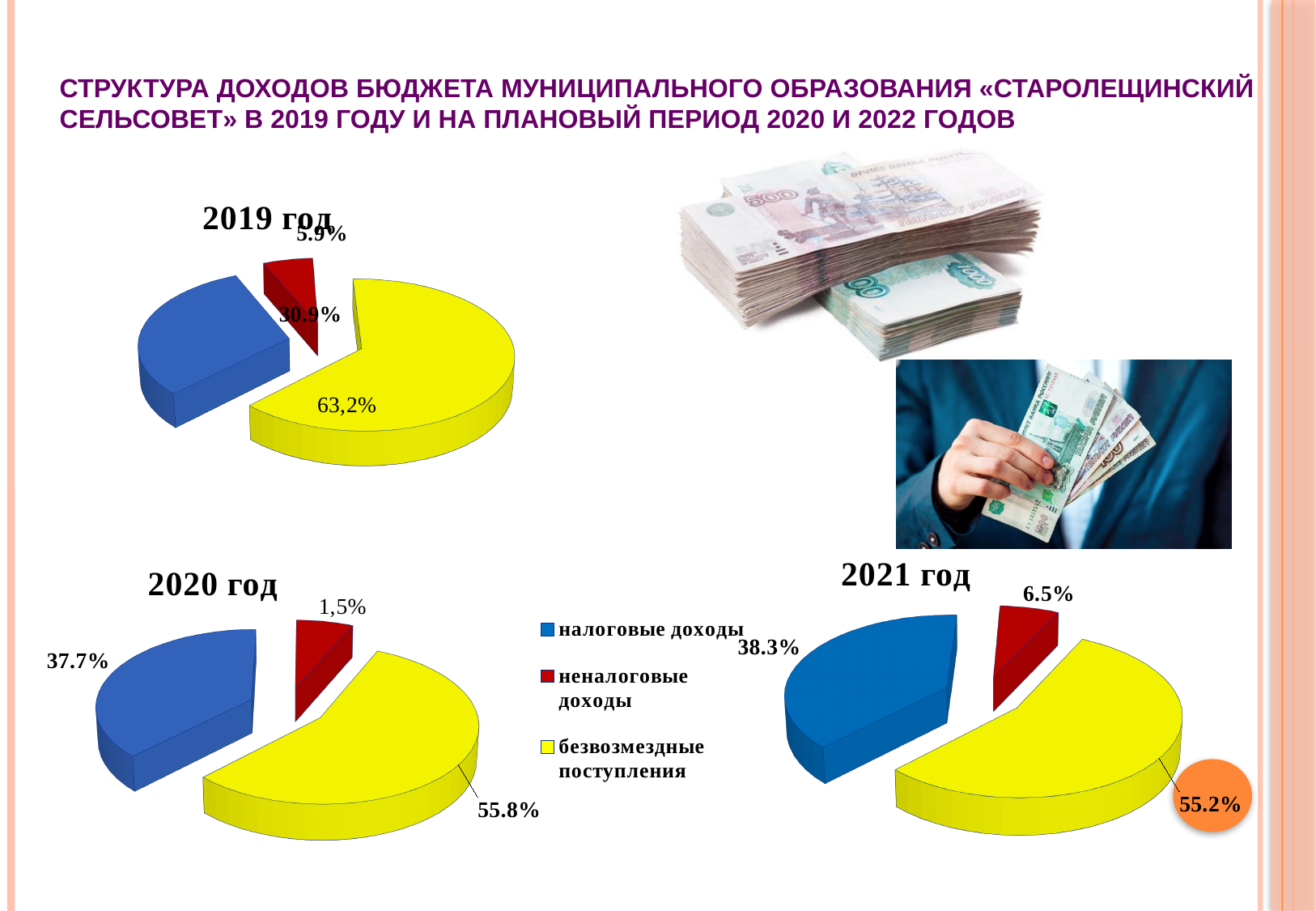
In the 2021 год pie chart, what share is shown for неналоговые доходы (red slice)? 6.5% In the 2019 год pie chart, what share is shown for налоговые доходы (blue slice)? 30.9% In the 2021 год pie chart, which category has the smallest share? неналоговые доходы How many categories does the legend list for the pie charts? 3 In the 2020 год pie chart, what share is shown for налоговые доходы (blue slice)? 37.7% In the 2020 год pie chart, what share is shown for неналоговые доходы (red slice)? 1,5% In the 2020 год pie chart, which category has the largest share? безвозмездные поступления What type of chart is used for the 2019 год, 2020 год and 2021 год data? Pie chart In the 2019 год pie chart, what share is shown for безвозмездные поступления (yellow slice)? 63,2% In the 2021 год pie chart, what share is shown for безвозмездные поступления (yellow slice)? 55.2% Which is larger: the share of налоговые доходы in the 2020 год chart or in the 2021 год chart? 2021 год In the 2020 год pie chart, what is the difference between the shares of безвозмездные поступления and налоговые доходы? 18.1%